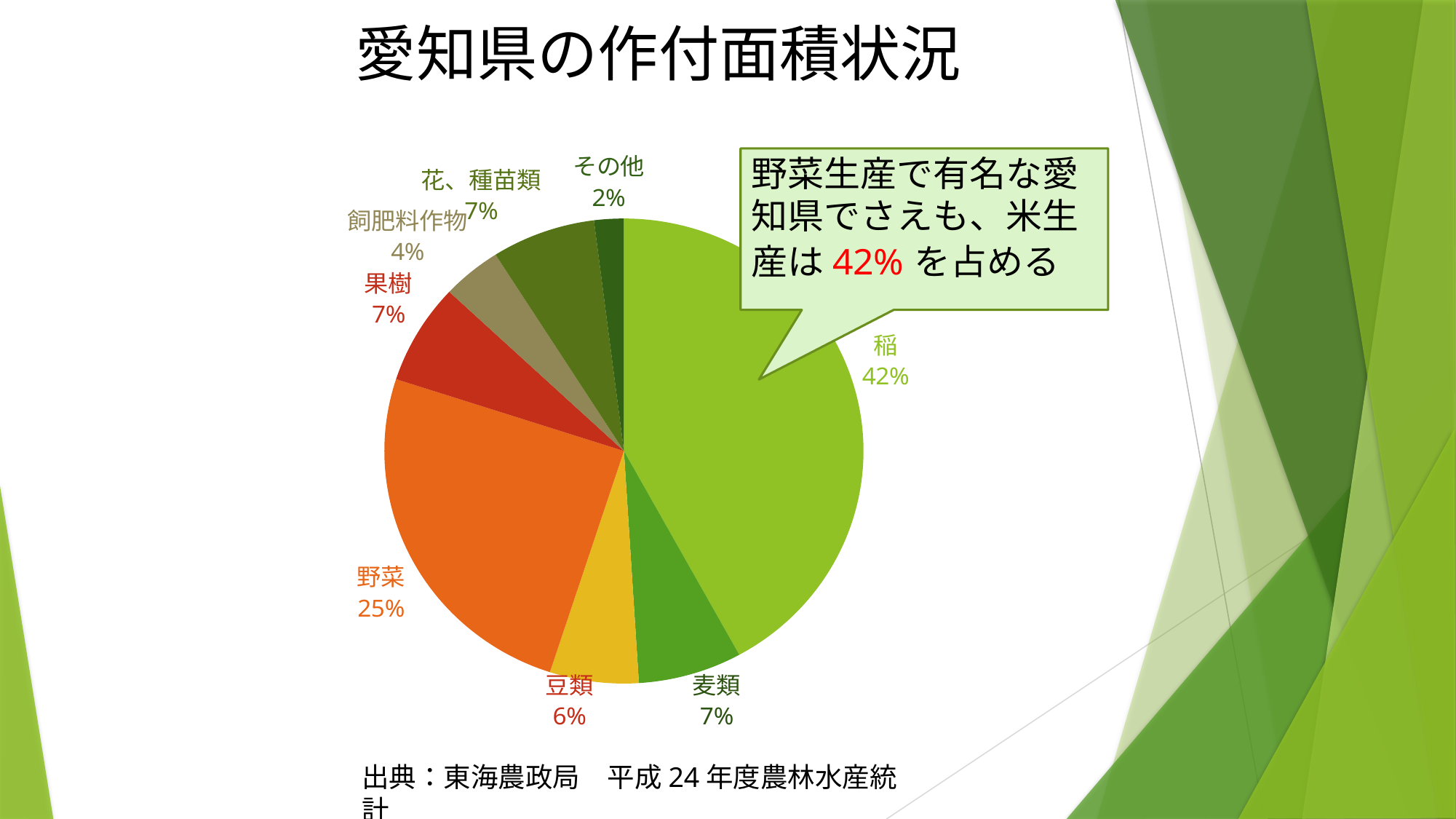
What kind of chart is shown on the slide? pie chart What is the value shown for 野菜? 25% Which category has the largest slice of the pie? 稲 Which category has the smallest slice of the pie? その他 What share of the pie does 稲 account for? 42% What is the value shown for その他? 2% Which is larger, the share of 野菜 or the share of 麦類? 野菜 What is the value shown for 飼肥料作物? 4% What is the difference between the shares of 稲 and 野菜? 17% What is the value shown for 豆類? 6% What is the title of the slide containing the chart? 愛知県の作付面積状況 How many categories are shown in the pie chart? 8